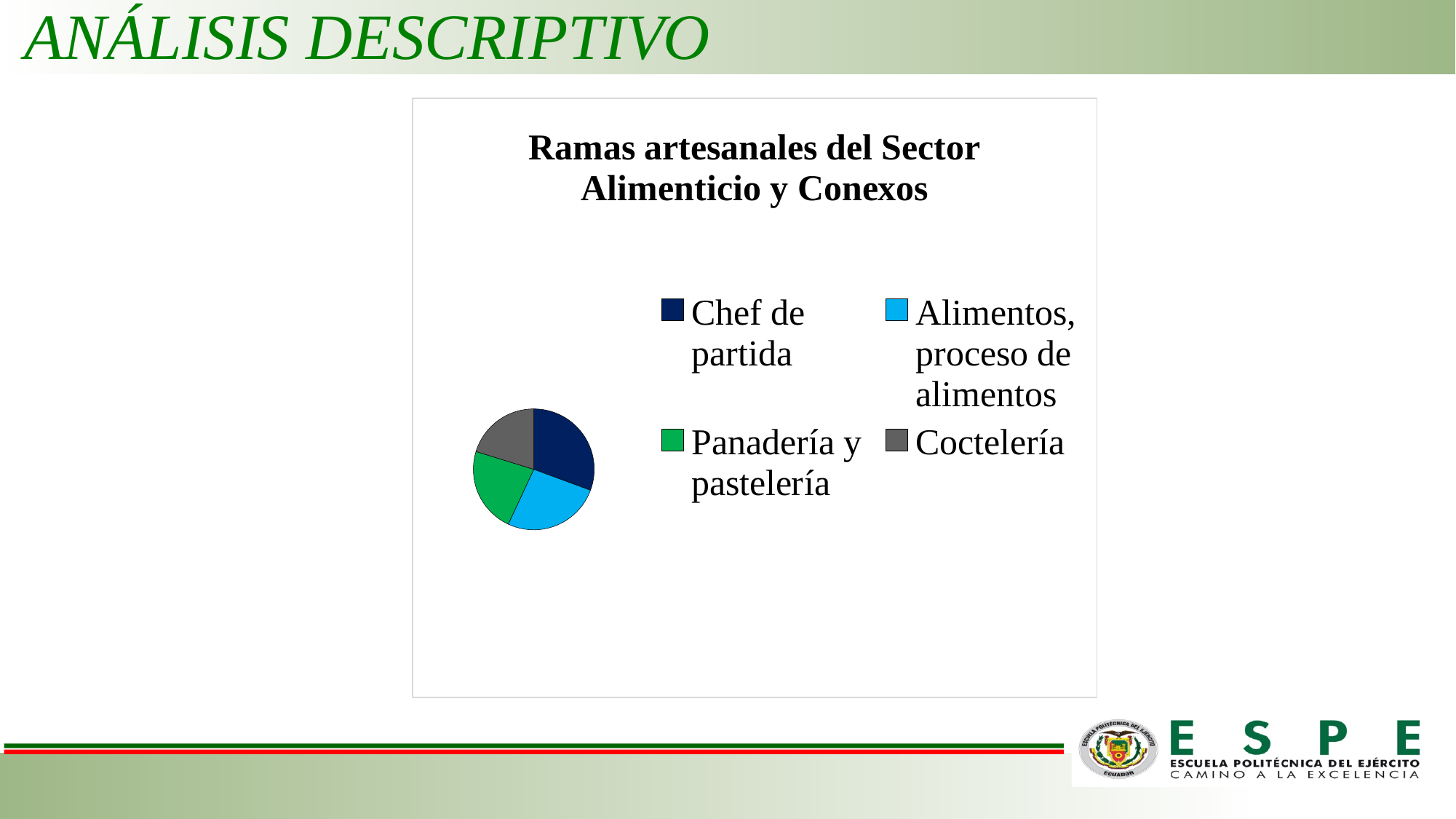
Which category is shown in green in the pie chart? Panadería y pastelería What is the title of the pie chart? Ramas artesanales del Sector Alimenticio y Conexos How many entries does the legend of the pie chart list? 4 What kind of chart is shown on the slide? pie chart Which slice is larger, Chef de partida or Coctelería? Chef de partida Which slice is larger, Alimentos, proceso de alimentos or Coctelería? Alimentos, proceso de alimentos How many slices does the pie chart have? 4 Which category has the largest slice of the pie chart? Chef de partida Which category has the smallest slice of the pie chart? Coctelería Which slice is larger, Chef de partida or Panadería y pastelería? Chef de partida